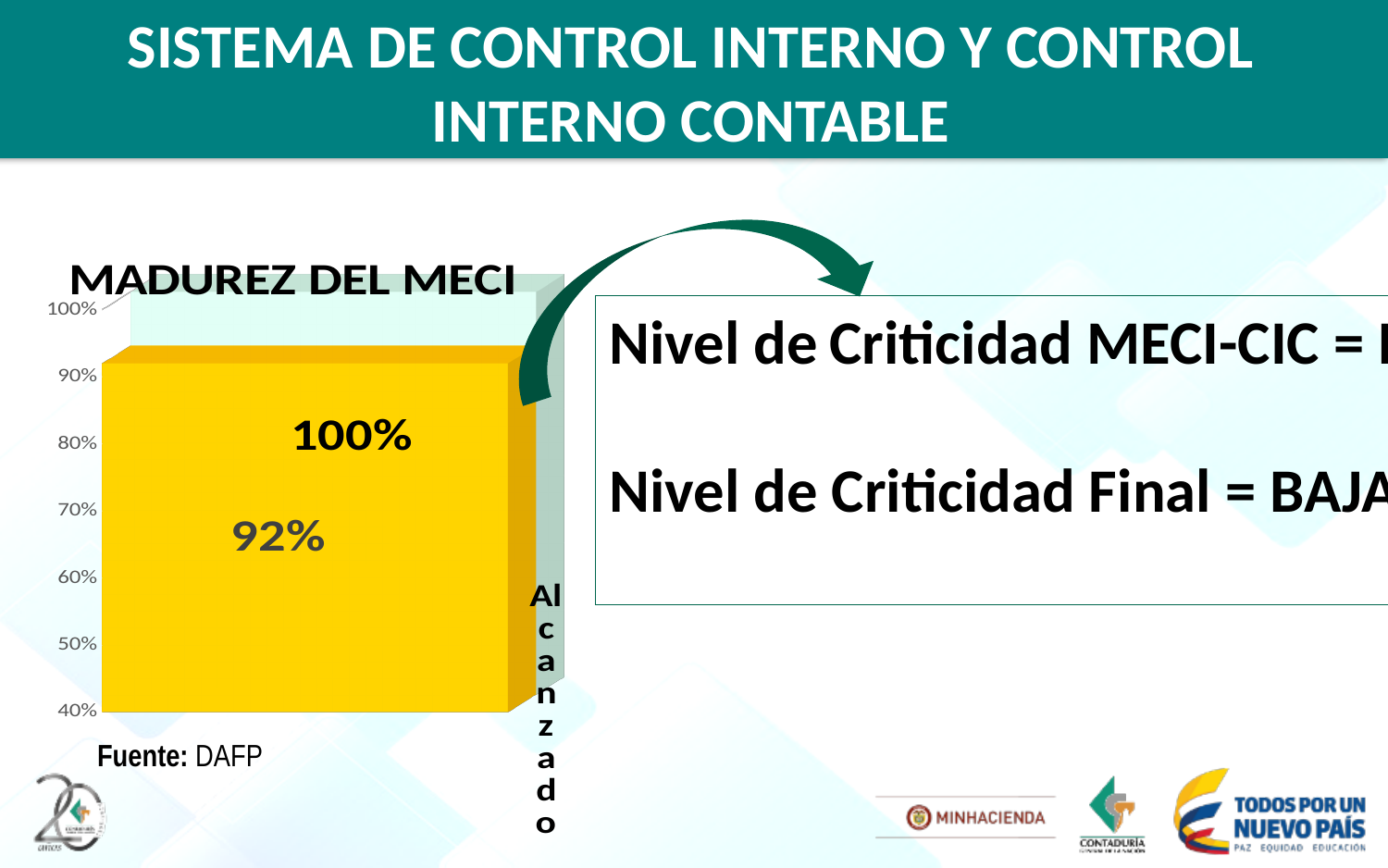
What is the value shown by the lower data label on the yellow bar in the MADUREZ DEL MECI chart? 92% What is the highest tick value shown on the y axis of the MADUREZ DEL MECI chart? 100% What is the value shown by the upper data label in the MADUREZ DEL MECI chart? 100% What is the difference between the two data labels printed in the MADUREZ DEL MECI chart, 100% and 92%? 8% What kind of chart is shown under the title MADUREZ DEL MECI? area chart What is the lowest tick value shown on the y axis of the MADUREZ DEL MECI chart? 40% What source is cited below the MADUREZ DEL MECI chart? DAFP What is the title of the chart on the slide? MADUREZ DEL MECI Is the top of the yellow bar in the MADUREZ DEL MECI chart greater or less than 80%? greater What is the label of the category shown on the x axis of the MADUREZ DEL MECI chart? Alcanzado In the MADUREZ DEL MECI chart, which of the two printed values is larger, 100% or 92%? 100%